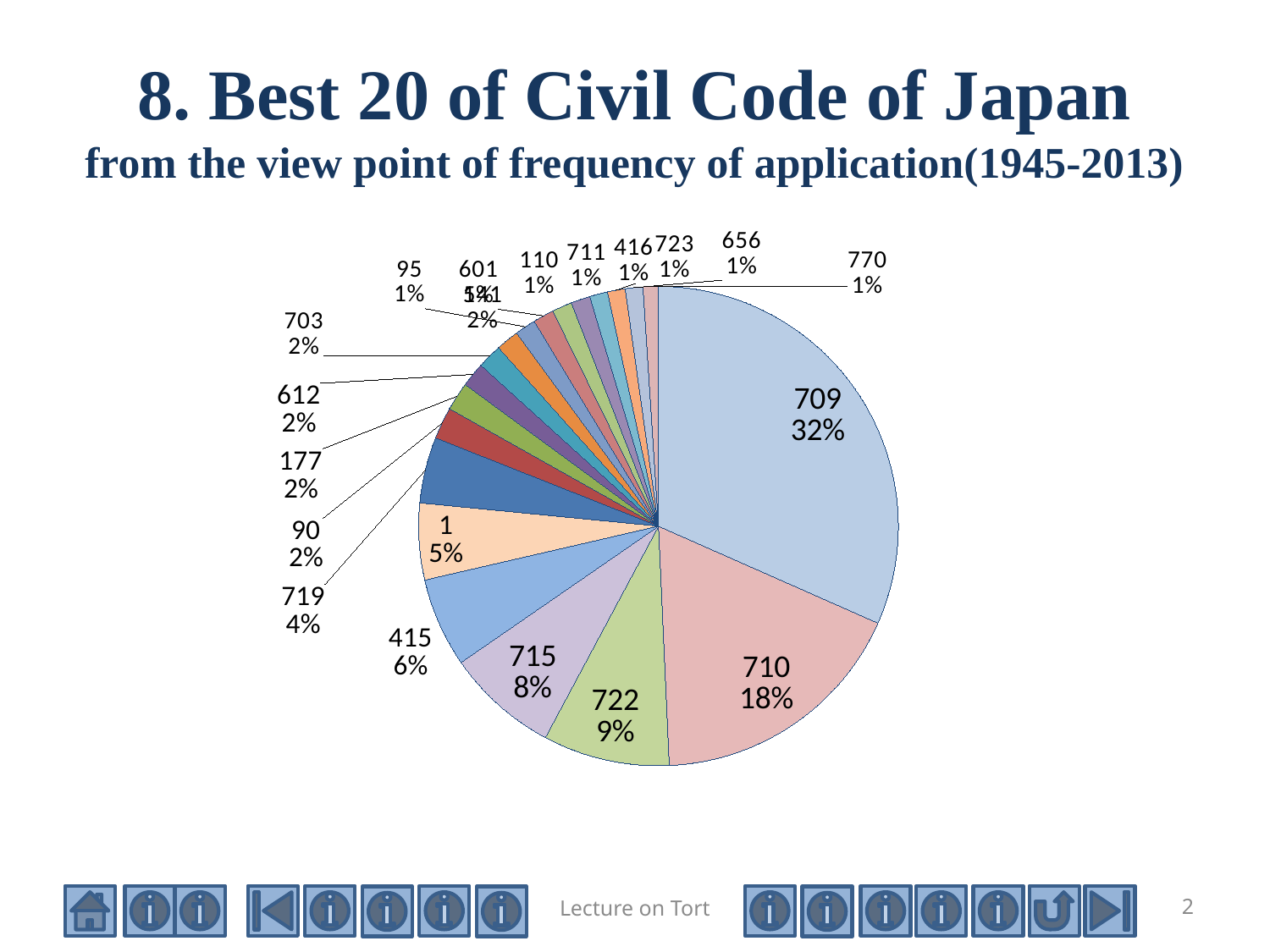
Which has the larger share, article 722 or article 715? 722 What percentage is shown for article 710? 18% Which article has the largest slice of the pie? 709 What kind of chart is shown on the slide? Pie chart What percentage is shown for article 719? 4% How many slices does the pie chart have? 20 What percentage is shown for article 90? 2% What percentage is shown for article 715? 8% What percentage is shown for article 415? 6% What share of the pie does article 709 account for? 32% What percentage is shown for article 722? 9% What is the difference in percentage points between the shares of article 709 and article 710? 14